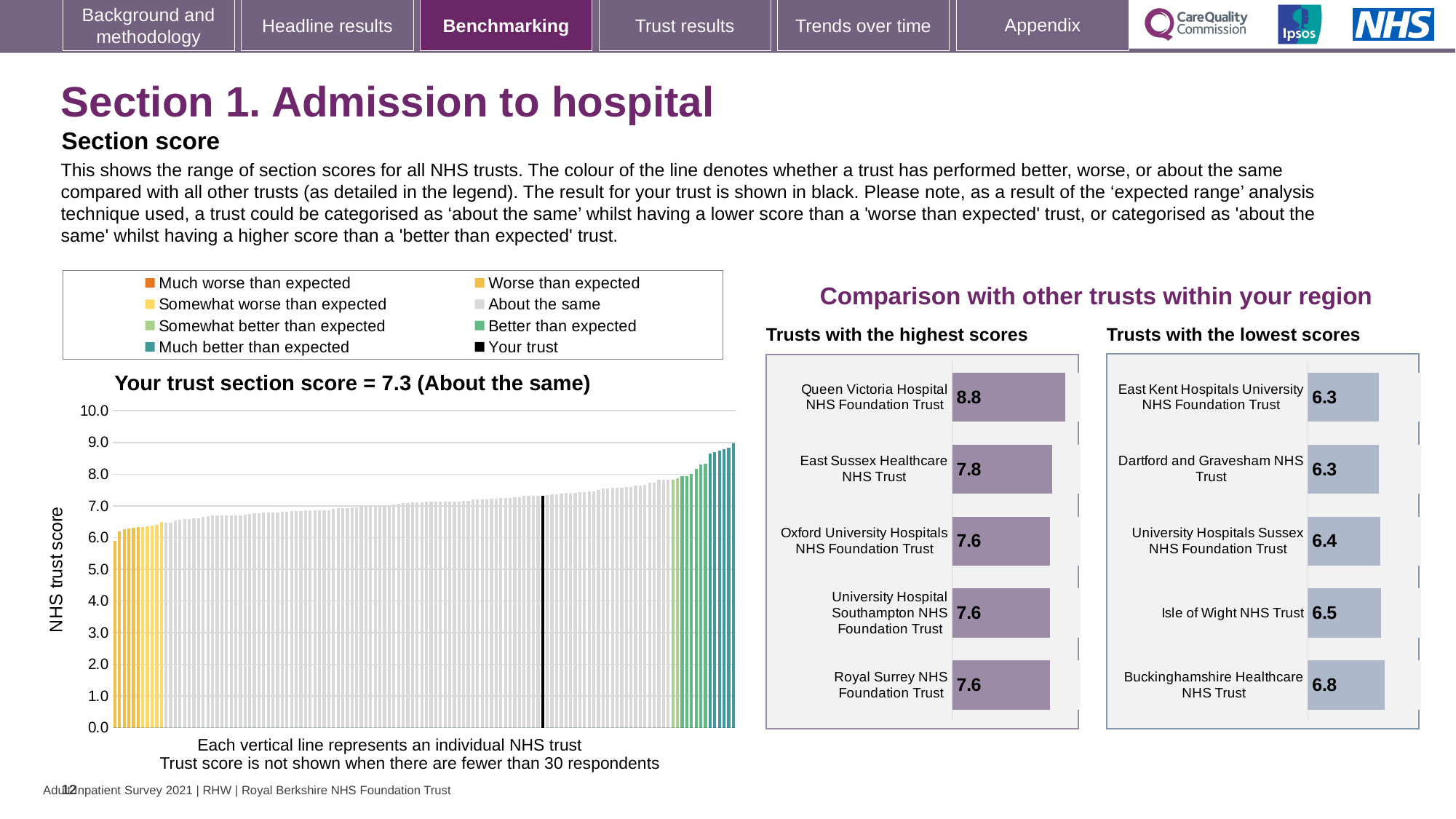
On the 'Your trust section score' chart, is the value for your trust greater or less than 7.0? greater What kind of chart is the 'Your trust section score' chart? bar chart On the 'Your trust section score' chart, do the bars rise or fall from left to right? rise On the 'Trusts with the highest scores' chart, what is the score for Queen Victoria Hospital NHS Foundation Trust? 8.8 On the 'Trusts with the lowest scores' chart, which trust has the highest score? Buckinghamshire Healthcare NHS Trust On the 'Trusts with the lowest scores' chart, what is the score for Isle of Wight NHS Trust? 6.5 On the 'Trusts with the highest scores' chart, how many trusts are shown? 5 How many entries does the legend above the 'Your trust section score' chart list? 8 On the 'Trusts with the lowest scores' chart, which has the larger score: University Hospitals Sussex NHS Foundation Trust or Isle of Wight NHS Trust? Isle of Wight NHS Trust What is the y-axis label on the 'Your trust section score' chart? NHS trust score On the 'Trusts with the highest scores' chart, what is the difference between the scores of Queen Victoria Hospital NHS Foundation Trust and East Sussex Healthcare NHS Trust? 1.0 On the 'Your trust section score' chart, what is the section score for your trust? 7.3